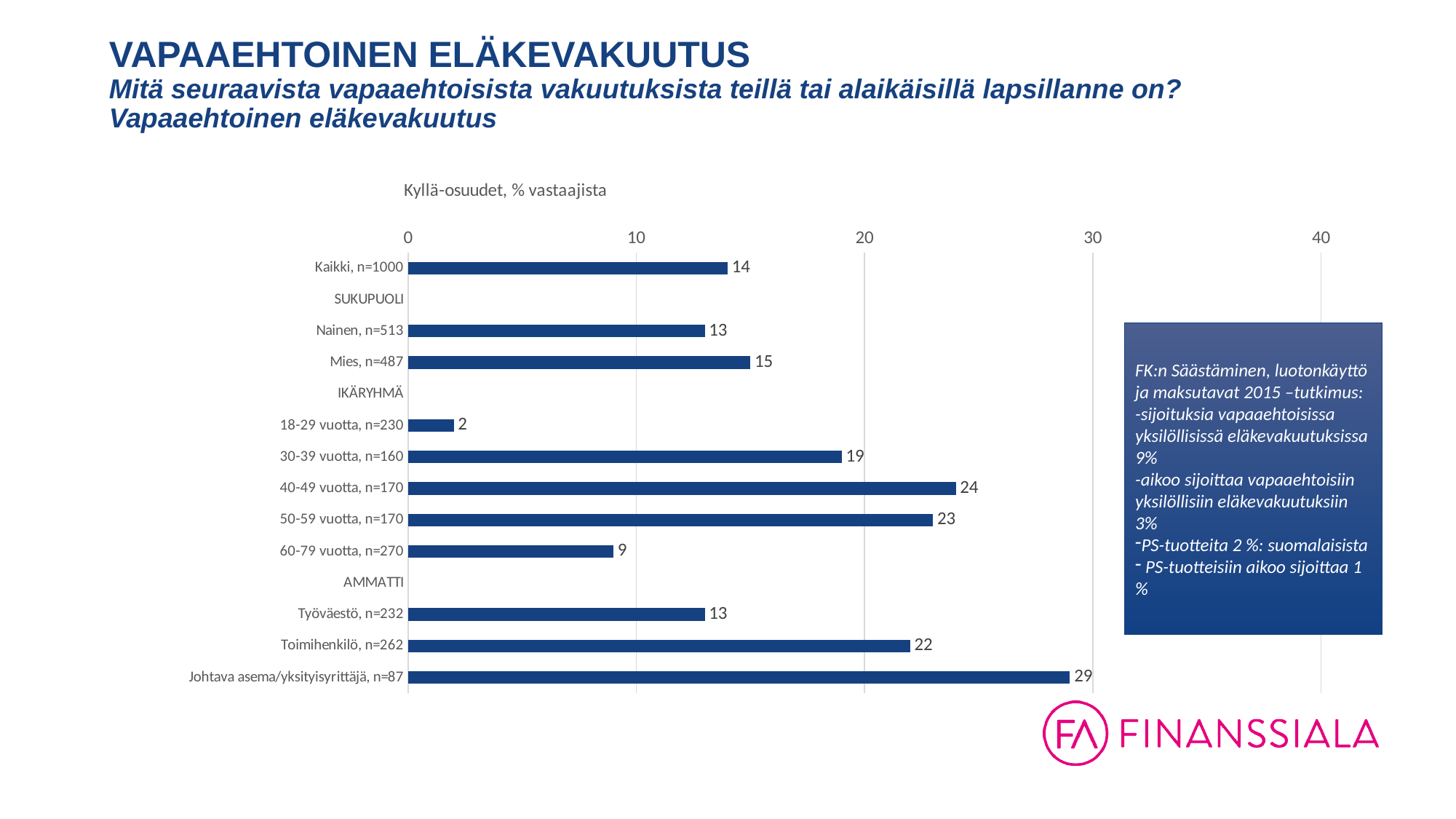
What is the value for Kaikki, n=1000? 14 How many bars are plotted in the chart? 11 What is the value for Toimihenkilö, n=262? 22 What kind of chart is shown on the slide? bar chart What is the difference between the values for Johtava asema/yksityisyrittäjä, n=87 and Työväestö, n=232? 16 Which category has the lowest value? 18-29 vuotta, n=230 Is the value for 50-59 vuotta, n=170 greater or less than 20? greater What is the axis label shown above the chart? Kyllä-osuudet, % vastaajista What is the difference between the values for Mies, n=487 and Nainen, n=513? 2 Which category has the highest value? Johtava asema/yksityisyrittäjä, n=87 Which is larger, the value for 30-39 vuotta, n=160 or the value for 60-79 vuotta, n=270? 30-39 vuotta, n=160 What is the value for 40-49 vuotta, n=170? 24